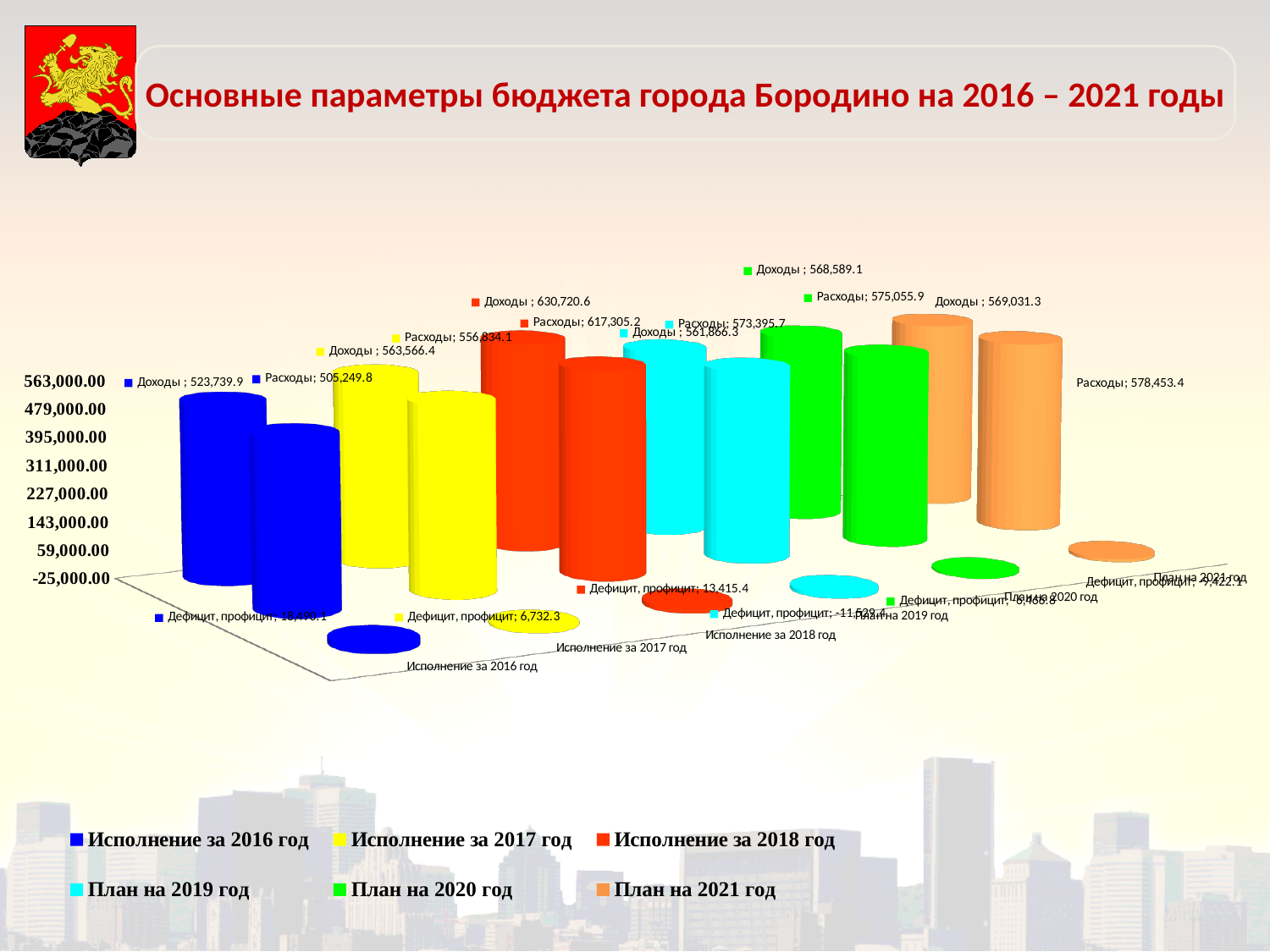
What is the value of Расходы for План на 2021 год? 578,453.4 For План на 2019 год, which is larger: Доходы or Расходы? Расходы What is the value of Расходы for План на 2019 год? 573,395.7 What is the difference between Доходы and Расходы for Исполнение за 2018 год? 13,415.4 Which series has the highest value for Доходы? Исполнение за 2018 год What kind of chart is shown on the slide? Bar chart Which series has the lowest value for Расходы? Исполнение за 2016 год What is the value of Дефицит, профицит for Исполнение за 2017 год? 6,732.3 What is the value of Доходы for Исполнение за 2018 год? 630,720.6 How many series does the legend list? 6 What is the title of the slide? Основные параметры бюджета города Бородино на 2016 – 2021 годы What is the value of Доходы for Исполнение за 2016 год? 523,739.9